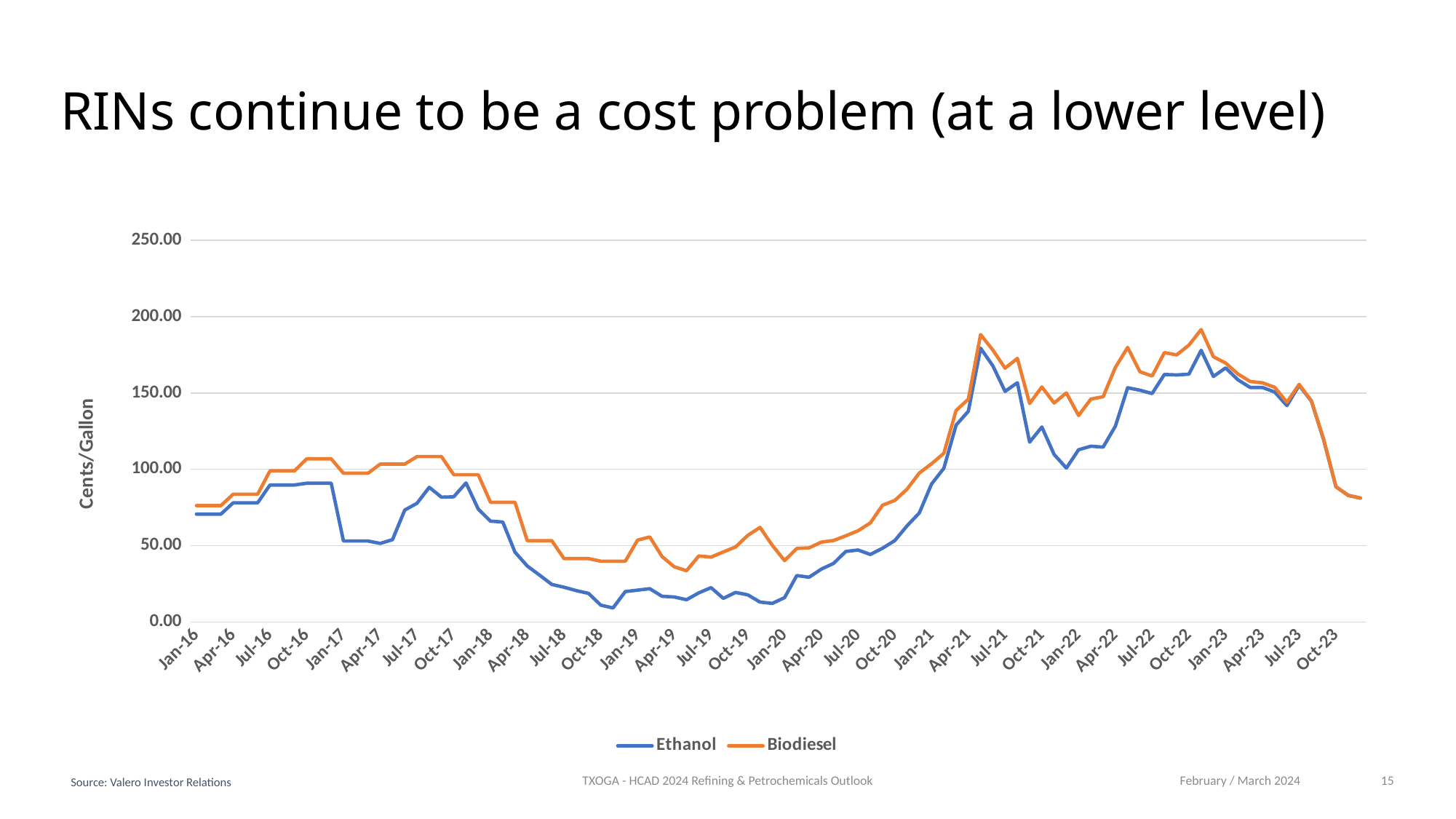
How many series does the legend list? 2 Do the Ethanol values rise or fall from Jan-18 to Oct-18? Fall At Jan-22, which series has the higher value, Ethanol or Biodiesel? Biodiesel Is the value for Ethanol at Oct-18 greater or less than 50? less What kind of chart is shown on the slide? Line chart At Jan-17, which series has the higher value, Ethanol or Biodiesel? Biodiesel What are the two series named in the legend? Ethanol and Biodiesel Is the value for Ethanol at Oct-21 greater or less than 100? greater Is the value for Biodiesel at Oct-23 greater or less than 100? less Which series reaches the highest peak value on the chart? Biodiesel What is the label on the vertical axis? Cents/Gallon